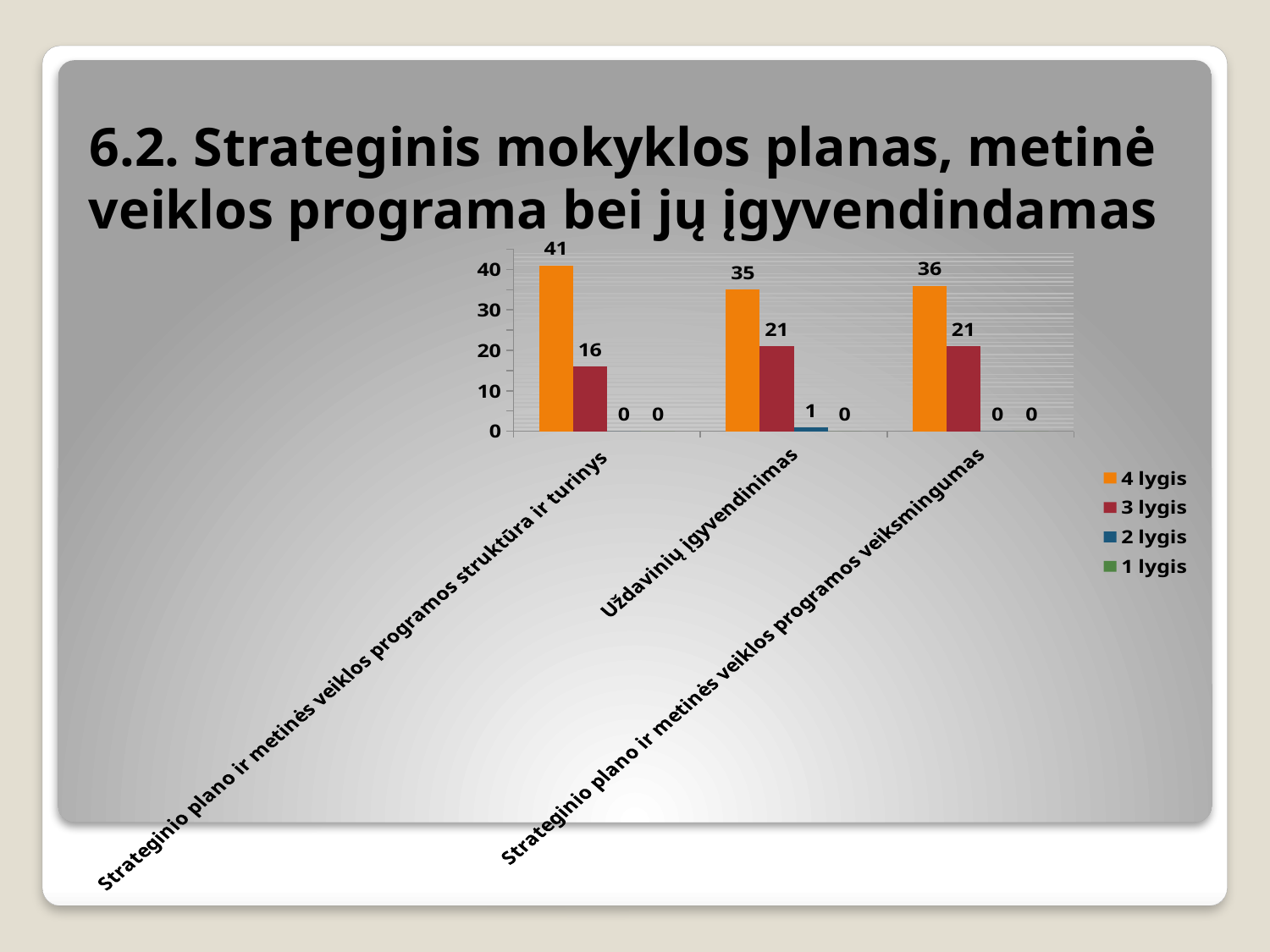
Which is larger: the "4 lygis" value for "Uždavinių įgyvendinimas" or for "Strateginio plano ir metinės veiklos programos veiksmingumas"? Strateginio plano ir metinės veiklos programos veiksmingumas How many categories are shown on the x axis of the chart? 3 What is the value of "4 lygis" for "Strateginio plano ir metinės veiklos programos veiksmingumas"? 36 Which category has the highest "4 lygis" value? Strateginio plano ir metinės veiklos programos struktūra ir turinys Which series is shown in orange in the chart legend? 4 lygis What is the value of "4 lygis" for "Uždavinių įgyvendinimas"? 35 How many series does the chart legend list? 4 What is the value of "2 lygis" for "Uždavinių įgyvendinimas"? 1 What is the value of "3 lygis" for "Strateginio plano ir metinės veiklos programos struktūra ir turinys"? 16 What kind of chart is shown on the slide? Bar chart What is the difference between the "4 lygis" and "3 lygis" values for "Strateginio plano ir metinės veiklos programos struktūra ir turinys"? 25 Which category has the lowest "3 lygis" value? Strateginio plano ir metinės veiklos programos struktūra ir turinys